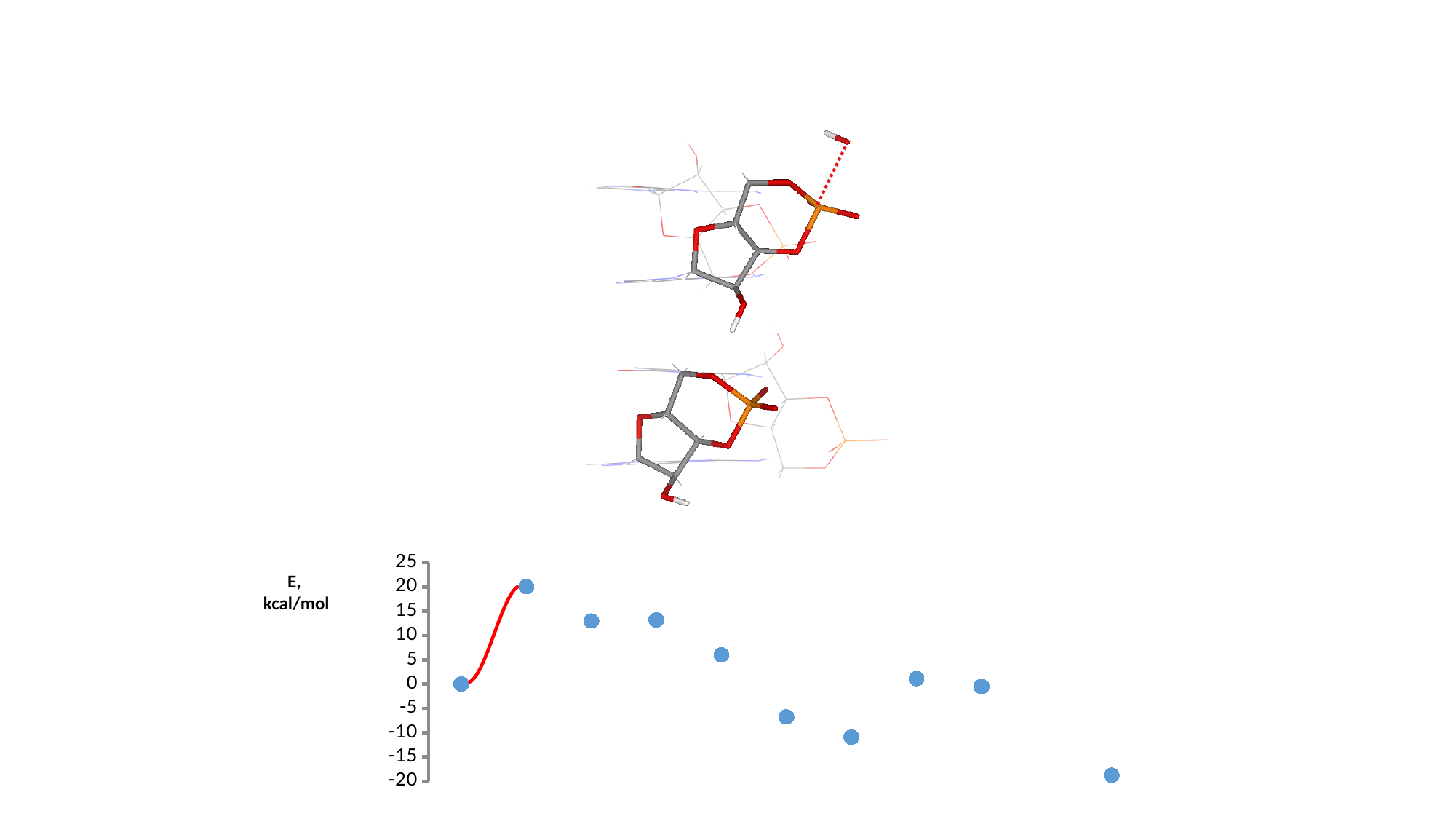
Is the value of the seventh point greater or less than -5? less What colour is the curve connecting the first two points in the chart? red Which point has the lowest value in the chart? the last (rightmost) point Is the value of the last (rightmost) point greater or less than -15? less What kind of chart is shown at the bottom of the slide? scatter chart What is the value of the first (leftmost) point in the chart? 0 What is the label on the y axis of the chart? E, kcal/mol Which is larger, the value of the second point or the value of the third point? the second point Which point has the highest value in the chart? the second point How many data points are plotted in the chart? 10 Is the value of the fifth point greater or less than 10? less